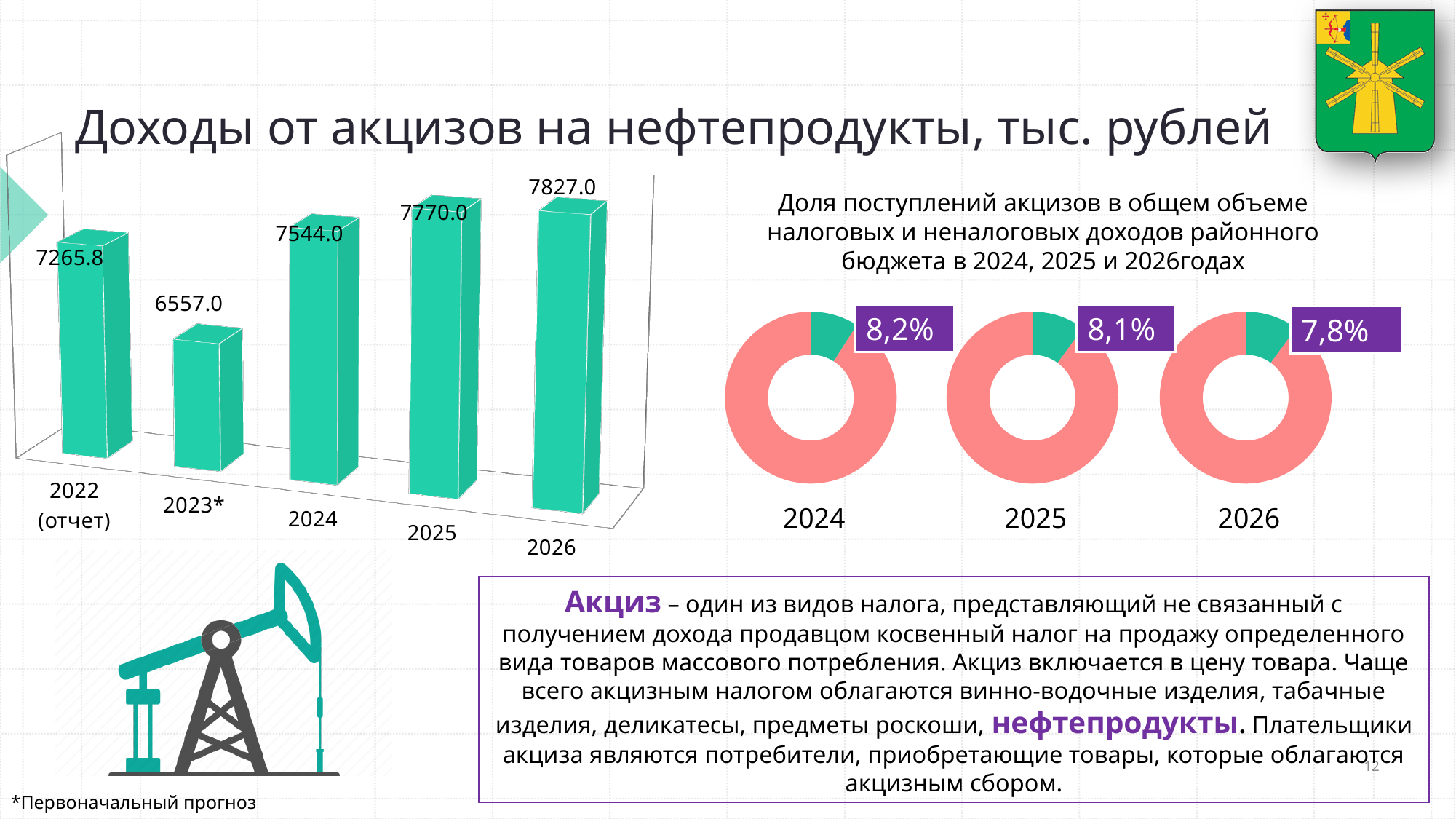
In the donut charts on the right, which year has the smallest share? 2026 In the bar chart on the left, what is the value for 2022 (отчет)? 7265.8 In the bar chart on the left, what is the difference between the values for 2026 and 2025? 57.0 What kind of chart is shown on the left of the slide? bar chart In the bar chart on the left, which year has the highest value? 2026 In the donut charts on the right, what share is shown for 2025? 8,1% In the bar chart on the left, what is the value for 2024? 7544.0 In the bar chart on the left, which year has the lowest value? 2023* In the bar chart on the left, what is the value for 2023*? 6557.0 In the bar chart on the left, do the values rise or fall from 2023* to 2026? rise In the bar chart on the left, which is larger: the value for 2022 (отчет) or the value for 2024? 2024 How many bars are in the bar chart on the left? 5